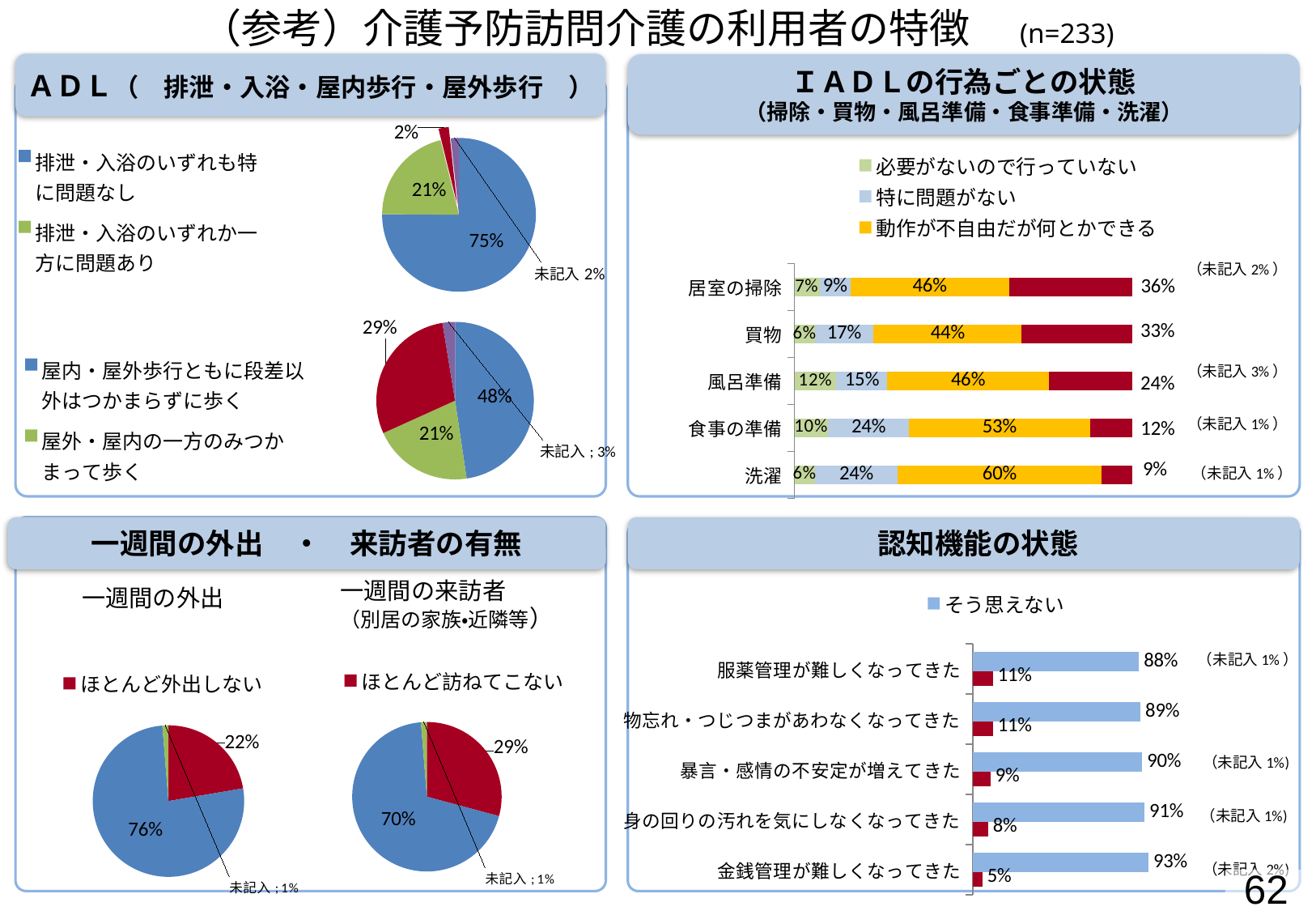
In the IADL chart (ＩＡＤＬの行為ごとの状態), how many categories are shown on the vertical axis? 5 In the IADL chart (ＩＡＤＬの行為ごとの状態), what is the value of the yellow segment (動作が不自由だが何とかできる) for 洗濯? 60% In the IADL chart (ＩＡＤＬの行為ごとの状態), what is the difference between the 特に問題がない values for 食事の準備 and 居室の掃除? 15% In the upper pie chart of the ADL panel (排泄・入浴), what is the value for 排泄・入浴のいずれも特に問題なし? 75% In the 認知機能の状態 chart, what kind of chart is used? bar chart In the IADL chart (ＩＡＤＬの行為ごとの状態), how many series does the legend list? 3 In the IADL chart (ＩＡＤＬの行為ごとの状態), which category has the highest value for the yellow segment (動作が不自由だが何とかできる)? 洗濯 In the 認知機能の状態 chart, what is the value of the そう思えない bar for 金銭管理が難しくなってきた? 93% In the 認知機能の状態 chart, which category has the lowest value for the red bar? 金銭管理が難しくなってきた In the IADL chart (ＩＡＤＬの行為ごとの状態), which category has the lowest value for the red segment? 洗濯 In the 一週間の外出 pie chart (bottom-left panel), what share is labelled ほとんど外出しない? 22% In the IADL chart (ＩＡＤＬの行為ごとの状態), what is the value of the red segment for 居室の掃除? 36%